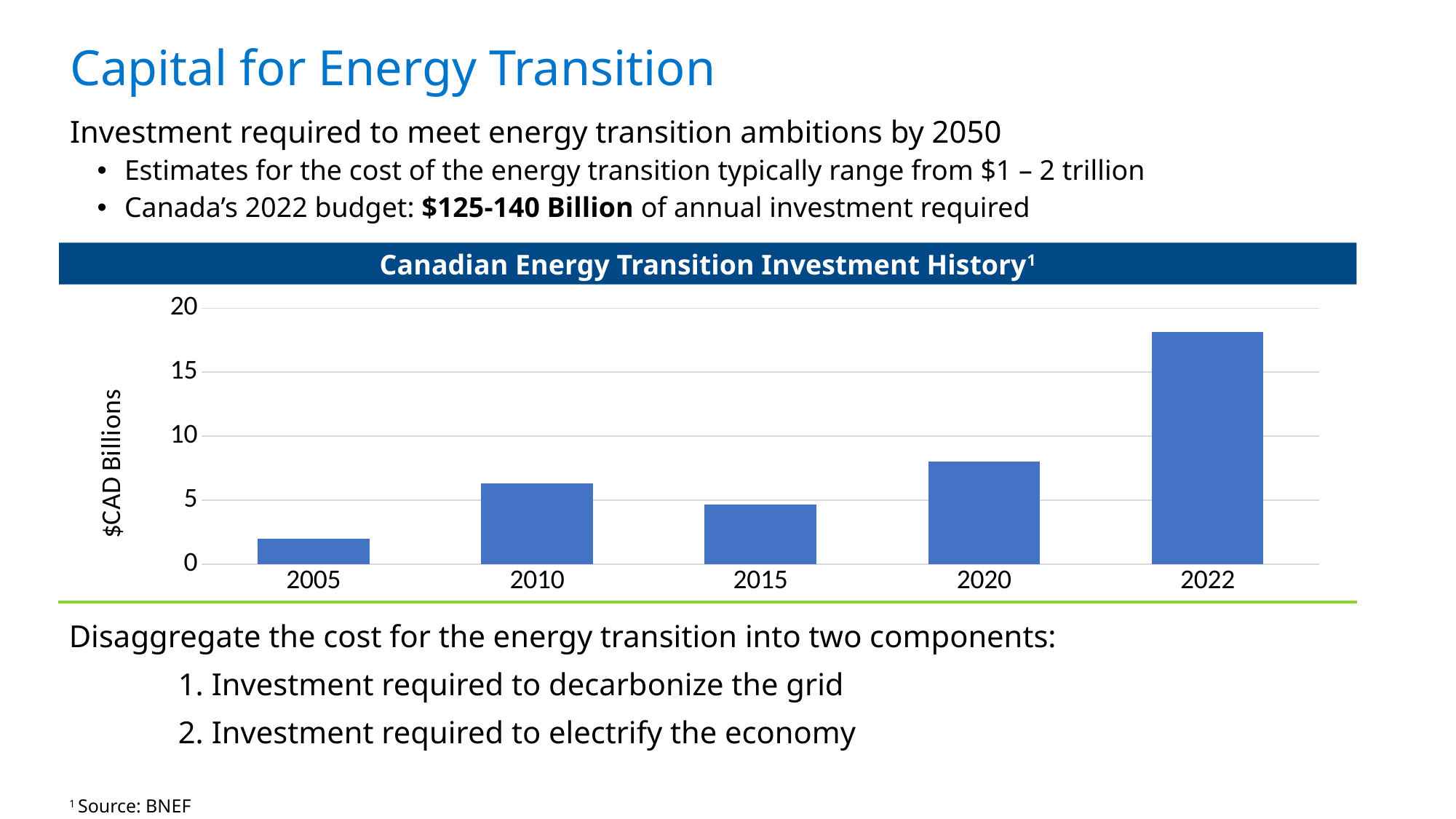
How many years are plotted on the chart? 5 Is the value for 2022 greater or less than 15? greater Is the value for 2010 greater or less than 5? greater What kind of chart is shown on the slide? bar chart Which is larger, the value for 2010 or the value for 2015? 2010 Overall, do the values rise or fall from 2005 to 2022? rise Which is larger, the value for 2020 or the value for 2010? 2020 Which year has the highest investment value? 2022 What is the label on the vertical axis of the chart? $CAD Billions Is the value for 2020 greater or less than 10? less Which year has the lowest investment value? 2005